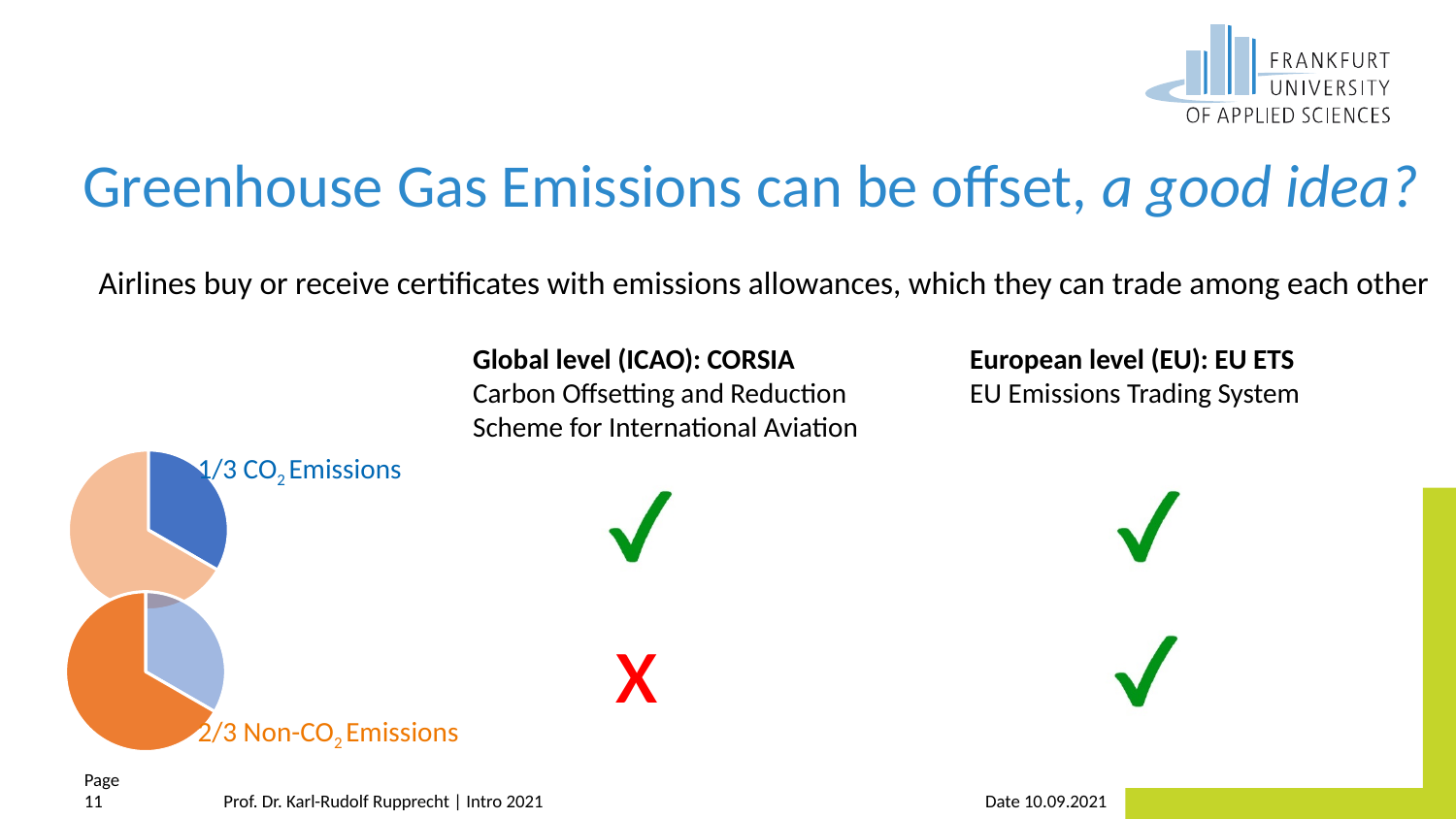
In the upper pie chart, what share of emissions is labelled as CO2 Emissions? 1/3 Which is larger according to the pie charts: the CO2 Emissions share or the Non-CO2 Emissions share? Non-CO2 Emissions Which labelled slice across the two pie charts represents the smallest share? 1/3 CO2 Emissions Is the Non-CO2 Emissions share in the lower pie chart greater or less than half of the pie? greater What colour is the slice labelled '2/3 Non-CO2 Emissions' in the lower pie chart? Orange What kind of chart is shown on the left side of the slide? Pie chart What colour is the slice labelled '1/3 CO2 Emissions' in the upper pie chart? Blue Is the CO2 Emissions share in the upper pie chart greater or less than half of the pie? less How many pie charts are shown on the slide? 2 In the lower pie chart, what share of emissions is labelled as Non-CO2 Emissions? 2/3 Which labelled slice across the two pie charts represents the largest share? 2/3 Non-CO2 Emissions